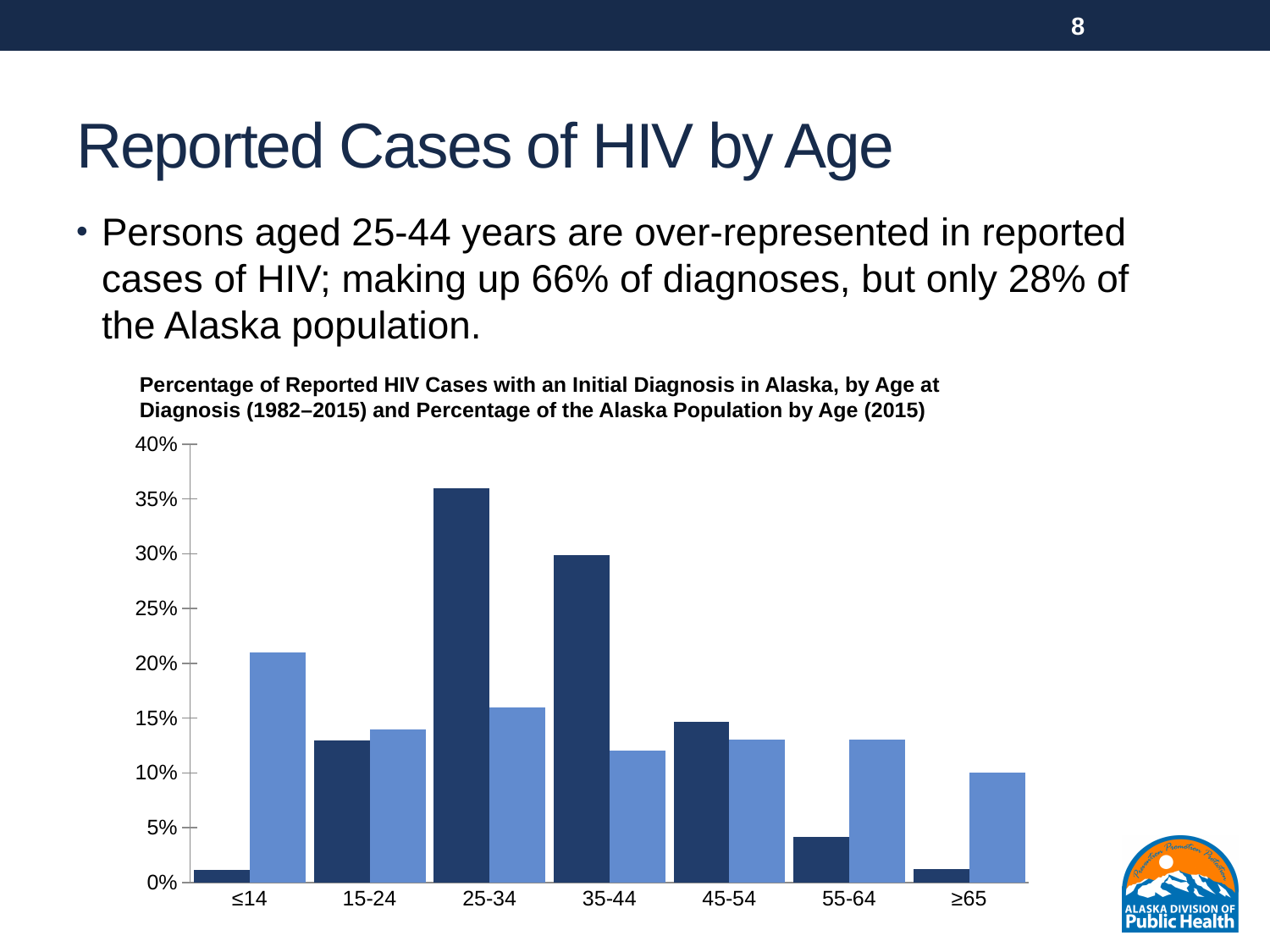
Which age category has the tallest dark blue bar? 25-34 How many age categories are shown on the x axis of the chart? 7 Is the light blue bar for ≤14 greater or less than 15%? greater For the ≤14 age group, which bar is taller, the dark blue or the light blue? light blue Which age category has the tallest light blue bar? ≤14 Is the dark blue bar for 25-34 greater or less than 30%? greater What is the highest value shown on the chart's y axis? 40% Is the dark blue bar for 55-64 greater or less than 5%? less Which age category has the shortest light blue bar? ≥65 For the 25-34 age group, which bar is taller, the dark blue or the light blue? dark blue What kind of chart is shown on the slide? bar chart